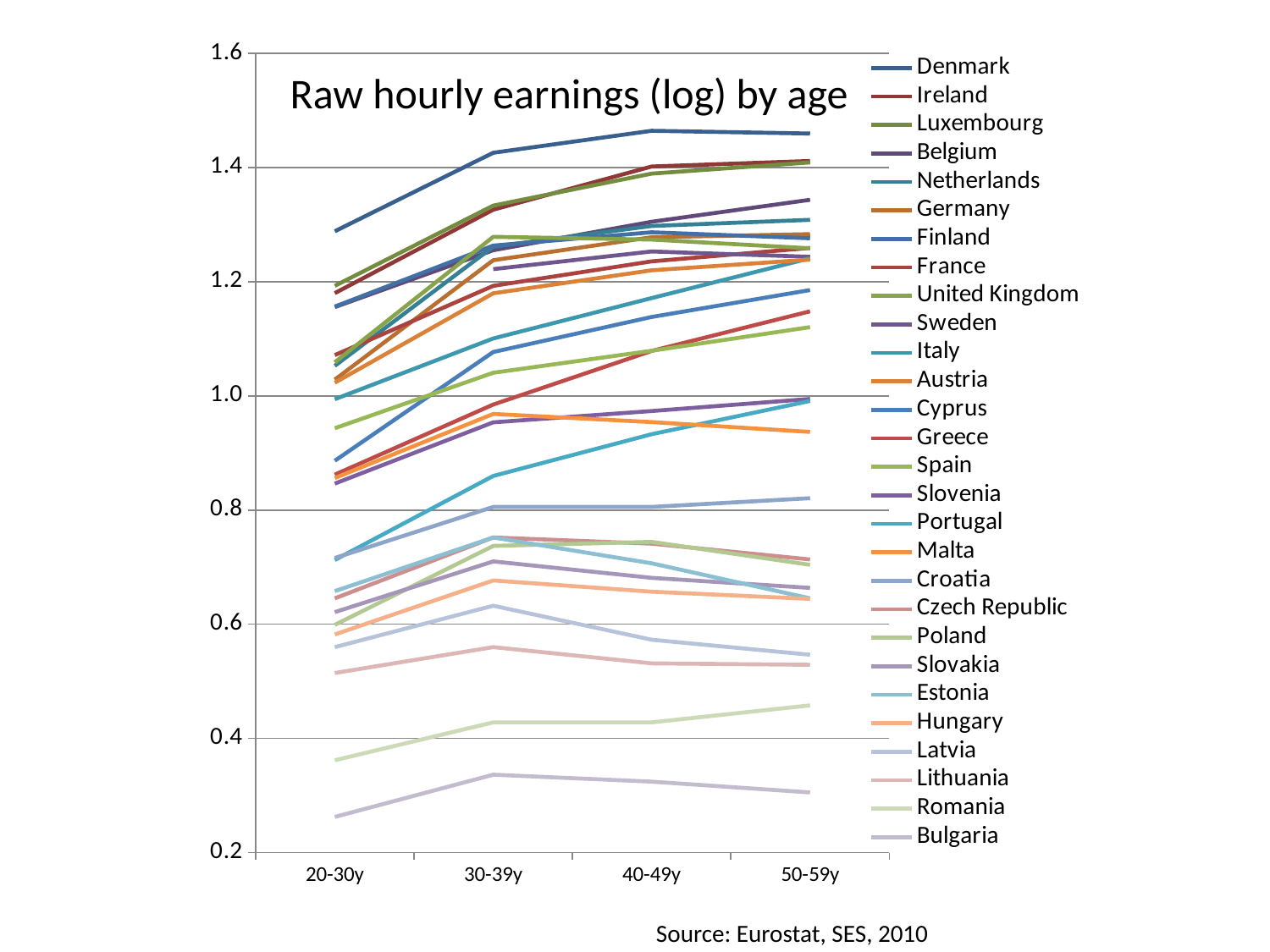
Which country has the highest line across all age groups? Denmark Do the values for Denmark rise or fall from 20-30y to 50-59y? rise Which is larger at 50-59y, the value for Denmark or the value for Bulgaria? Denmark How many countries does the legend list? 28 Is the value for Denmark at 50-59y greater or less than 1.4? greater What kind of chart is shown on the slide? line chart Is the value for Bulgaria at 50-59y greater or less than 0.4? less What is the title of the chart? Raw hourly earnings (log) by age Is the value for Malta at 50-59y greater or less than 1.0? less How many age groups are shown on the x axis? 4 Which country has the lowest line across all age groups? Bulgaria